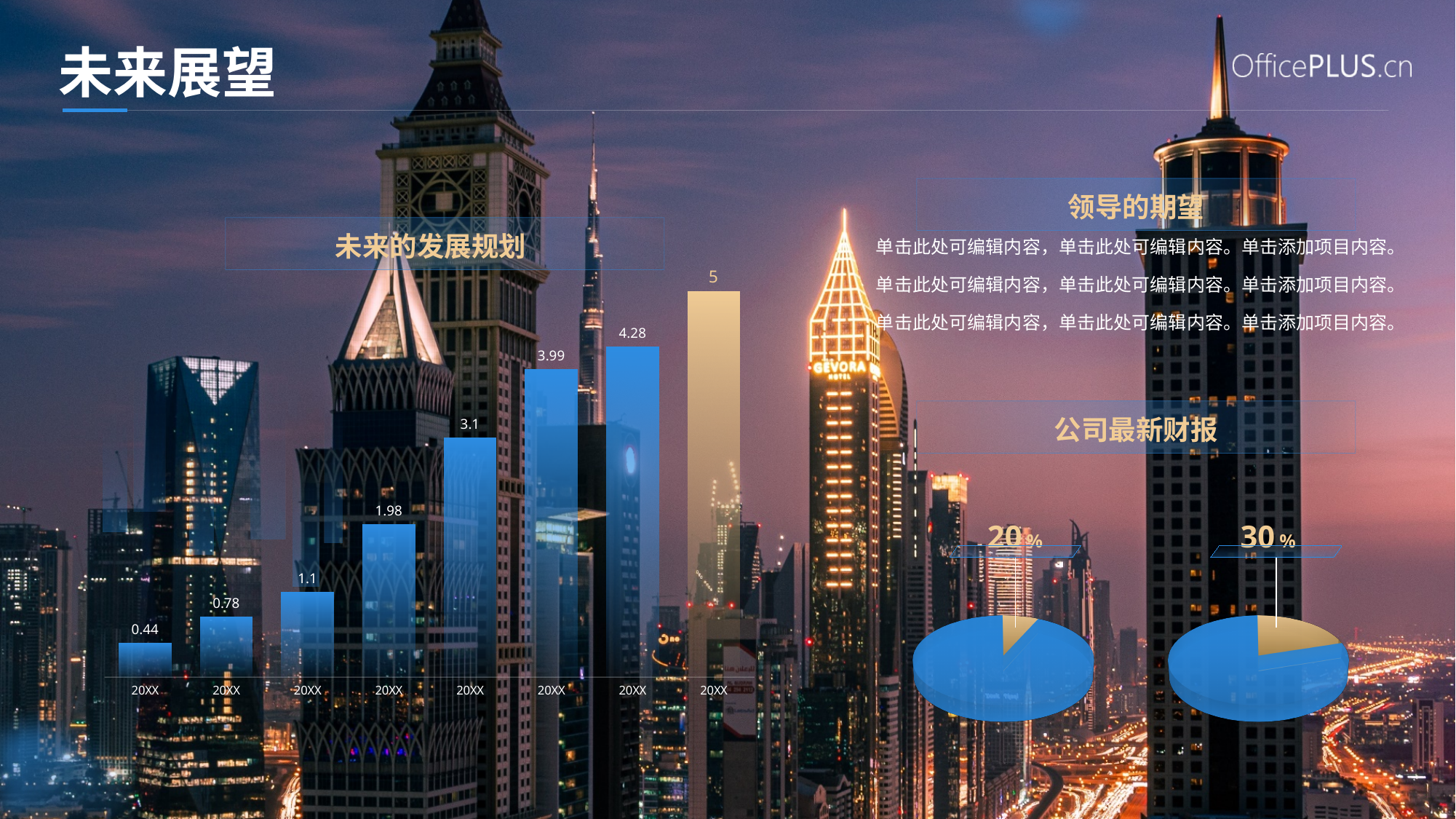
In the pie charts under 公司最新财报, what percentage is shown above the right pie chart? 30% In the bar chart under 未来的发展规划, what is the difference between the bars labeled 3.99 and 3.1? 0.89 What type of chart is shown under the title 未来的发展规划? bar chart In the bar chart under 未来的发展规划, how many bars are plotted? 8 In the bar chart under 未来的发展规划, do the values rise or fall from left to right? rise In the bar chart under 未来的发展规划, what is the value of the seventh bar from the left? 4.28 In the bar chart under 未来的发展规划, what is the difference between the last bar (5) and the first bar (0.44)? 4.56 In the bar chart under 未来的发展规划, which is larger: the third bar from the left or the second bar from the left? the third bar (1.1) In the pie charts under 公司最新财报, what percentage is shown above the left pie chart? 20% In the bar chart under 未来的发展规划, what is the value of the tallest (gold) bar on the far right? 5 In the bar chart under 未来的发展规划, what is the value of the fourth bar from the left? 1.98 In the bar chart under 未来的发展规划, what is the value of the shortest bar on the far left? 0.44